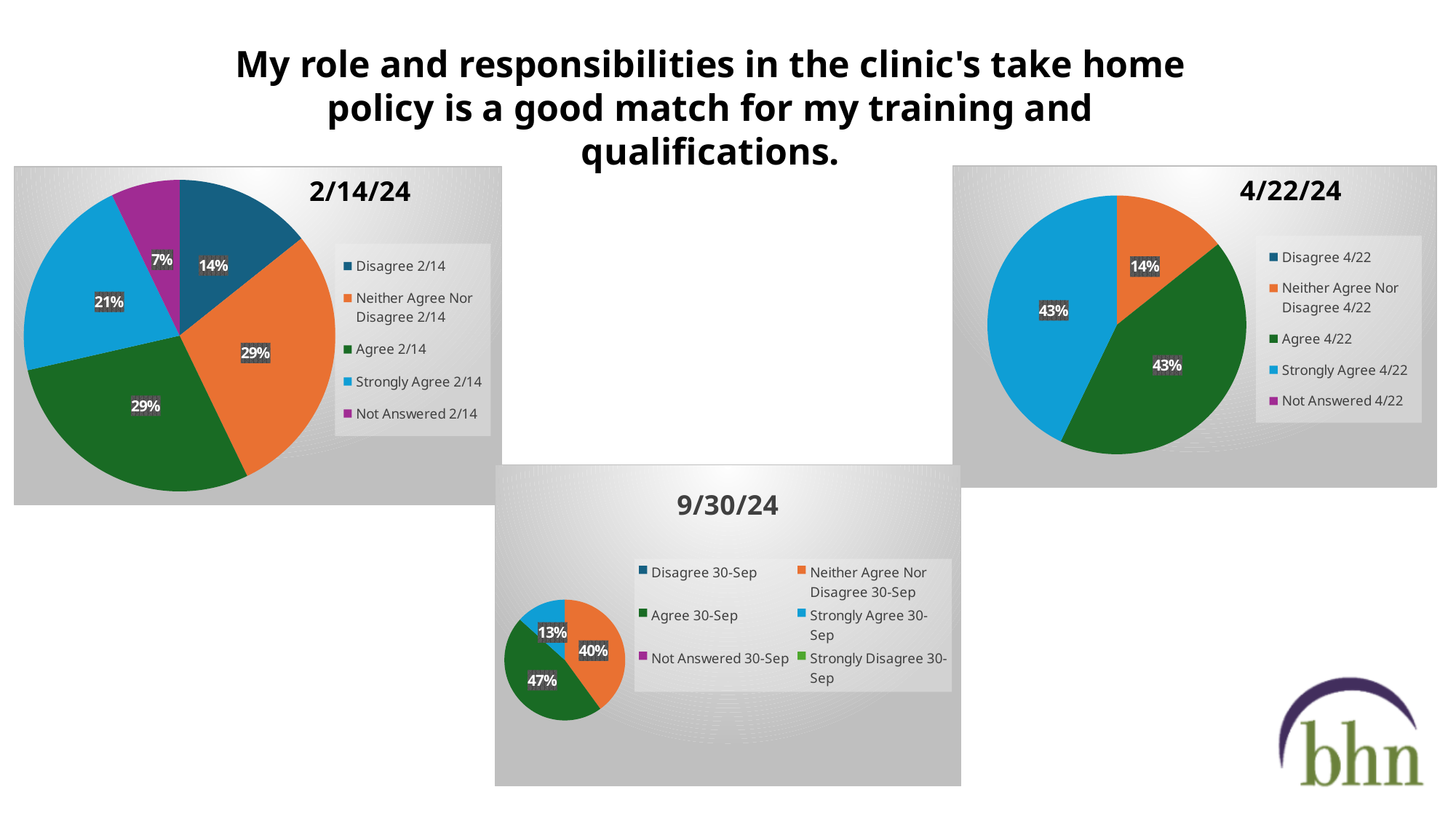
In the 2/14/24 chart, which category has the smallest slice? Not Answered 2/14 In the 2/14/24 chart, what percentage is shown for Not Answered 2/14? 7% In the 9/30/24 chart, what percentage is shown for Agree 30-Sep? 47% In the 4/22/24 chart, how many entries does the legend list? 5 In the 9/30/24 chart, how many entries does the legend list? 6 In the 2/14/24 chart, what percentage is shown for Strongly Agree 2/14? 21% In the 4/22/24 chart, what percentage is shown for Agree 4/22? 43% In the 2/14/24 chart, what is the difference between the Agree 2/14 share and the Disagree 2/14 share? 15% In the 9/30/24 chart, which category has the largest slice? Agree 30-Sep What kind of chart is the 2/14/24 chart? Pie chart In the 9/30/24 chart, which is larger: Neither Agree Nor Disagree 30-Sep or Strongly Agree 30-Sep? Neither Agree Nor Disagree 30-Sep In the 4/22/24 chart, what percentage is shown for Neither Agree Nor Disagree 4/22? 14%